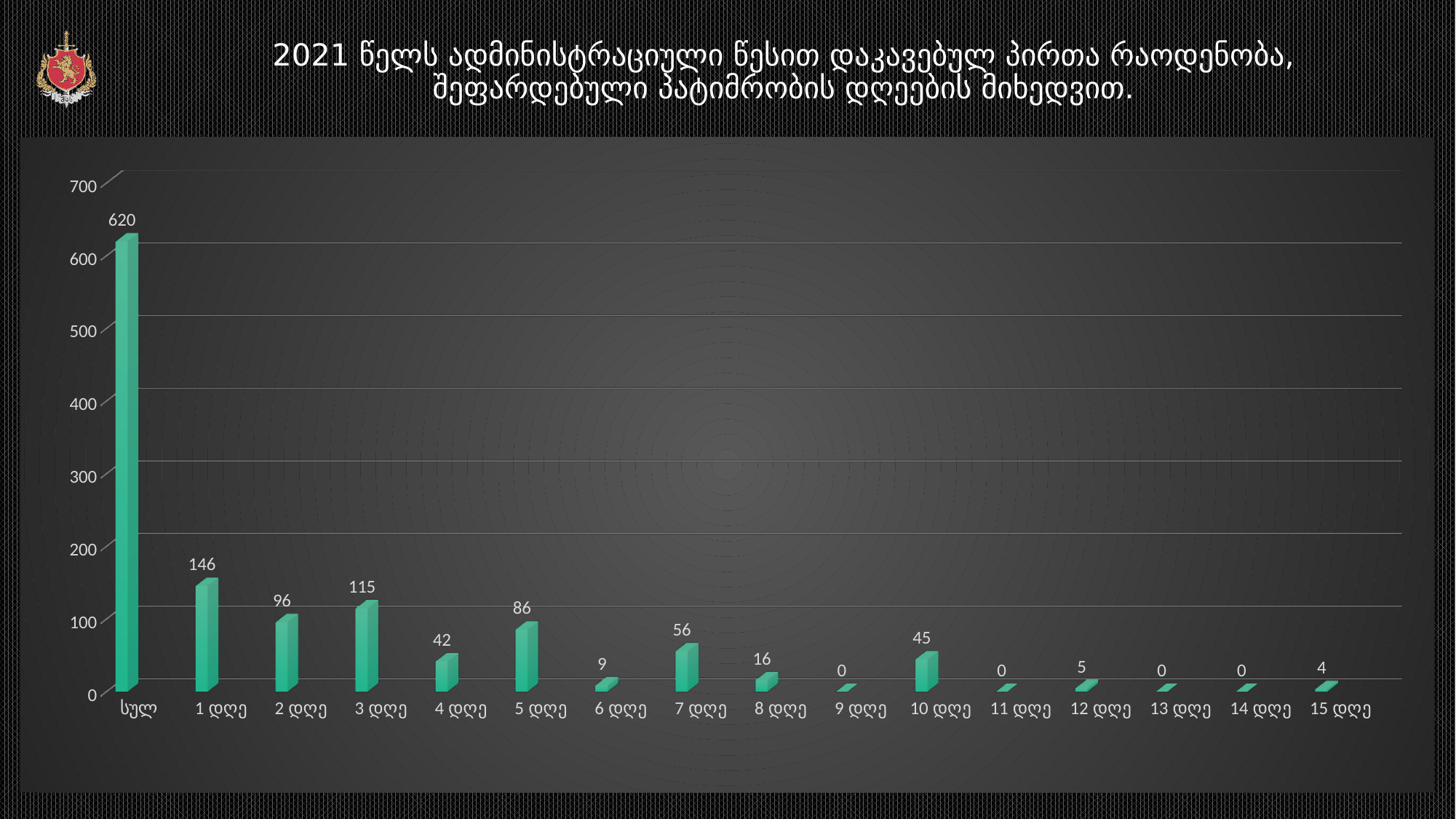
What is the difference between the values for "1 დღე" and "2 დღე"? 50 Is the value for "სულ" greater or less than 600? greater What is the value for "3 დღე"? 115 What kind of chart is shown on the slide? bar chart What is the value for the category "სულ"? 620 Excluding the "სულ" bar, which category has the highest value? 1 დღე What is the value for "15 დღე"? 4 Which is larger, the value for "5 დღე" or the value for "7 დღე"? 5 დღე How many categories are shown on the x axis? 16 What is the value for "8 დღე"? 16 What is the value for "10 დღე"? 45 How many categories have a value of 0? 4